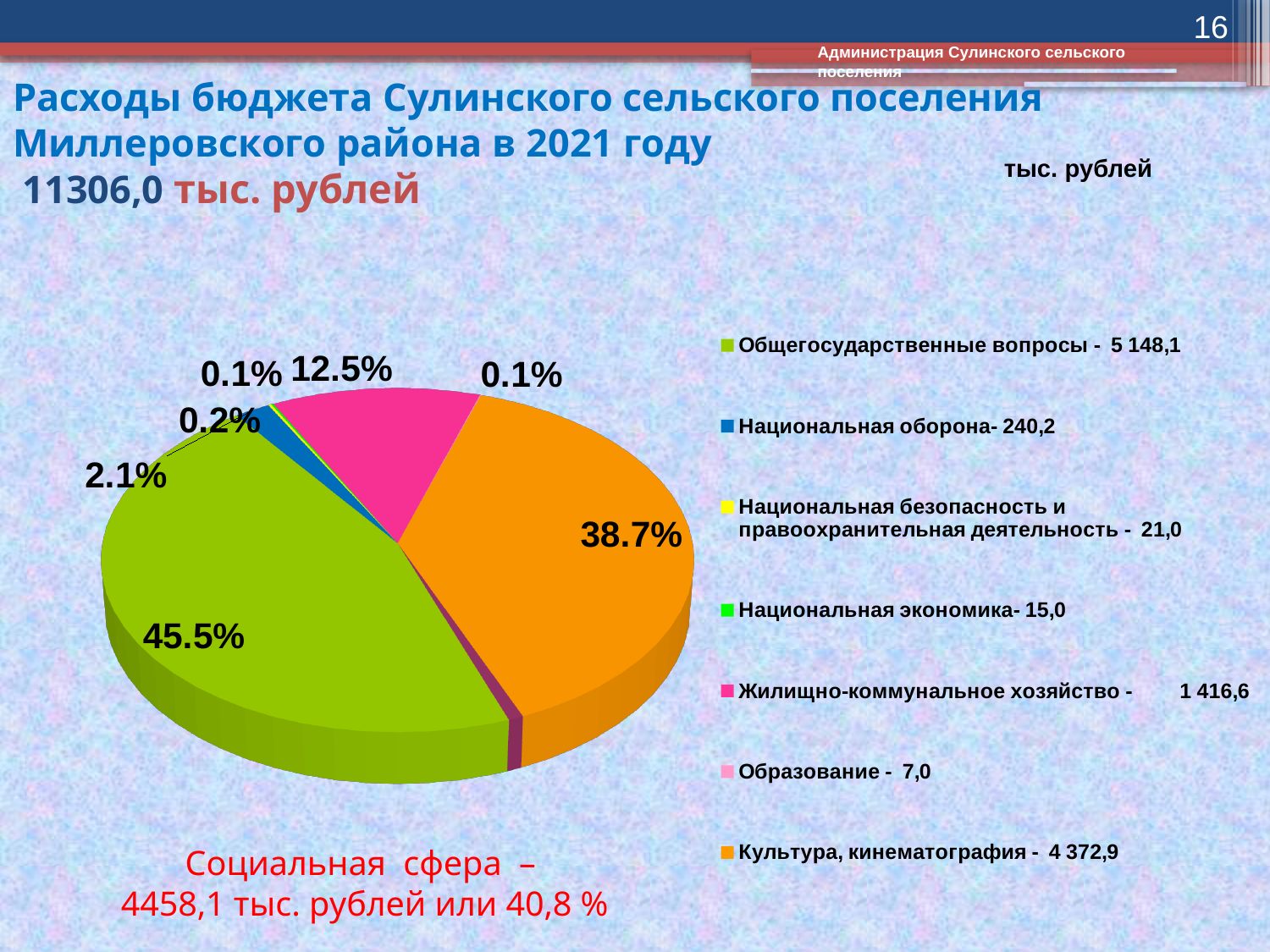
What value does the legend give for Национальная безопасность и правоохранительная деятельность? 21,0 What kind of chart is shown on the slide? pie chart What share of the pie does the largest slice (Общегосударственные вопросы) take? 45.5% How many slices does the pie chart have? 8 What value does the legend give for Образование? 7,0 What is the difference between the values for Общегосударственные вопросы and Культура, кинематография? 775,2 Which category has the largest expenditure in the pie chart? Общегосударственные вопросы What share of the pie does the Жилищно-коммунальное хозяйство slice take? 12.5% What value does the legend give for Национальная оборона? 240,2 How many entries does the legend of the pie chart list? 7 Which category has the smallest expenditure in the pie chart? Образование What share of the pie does the Культура, кинематография slice take? 38.7%